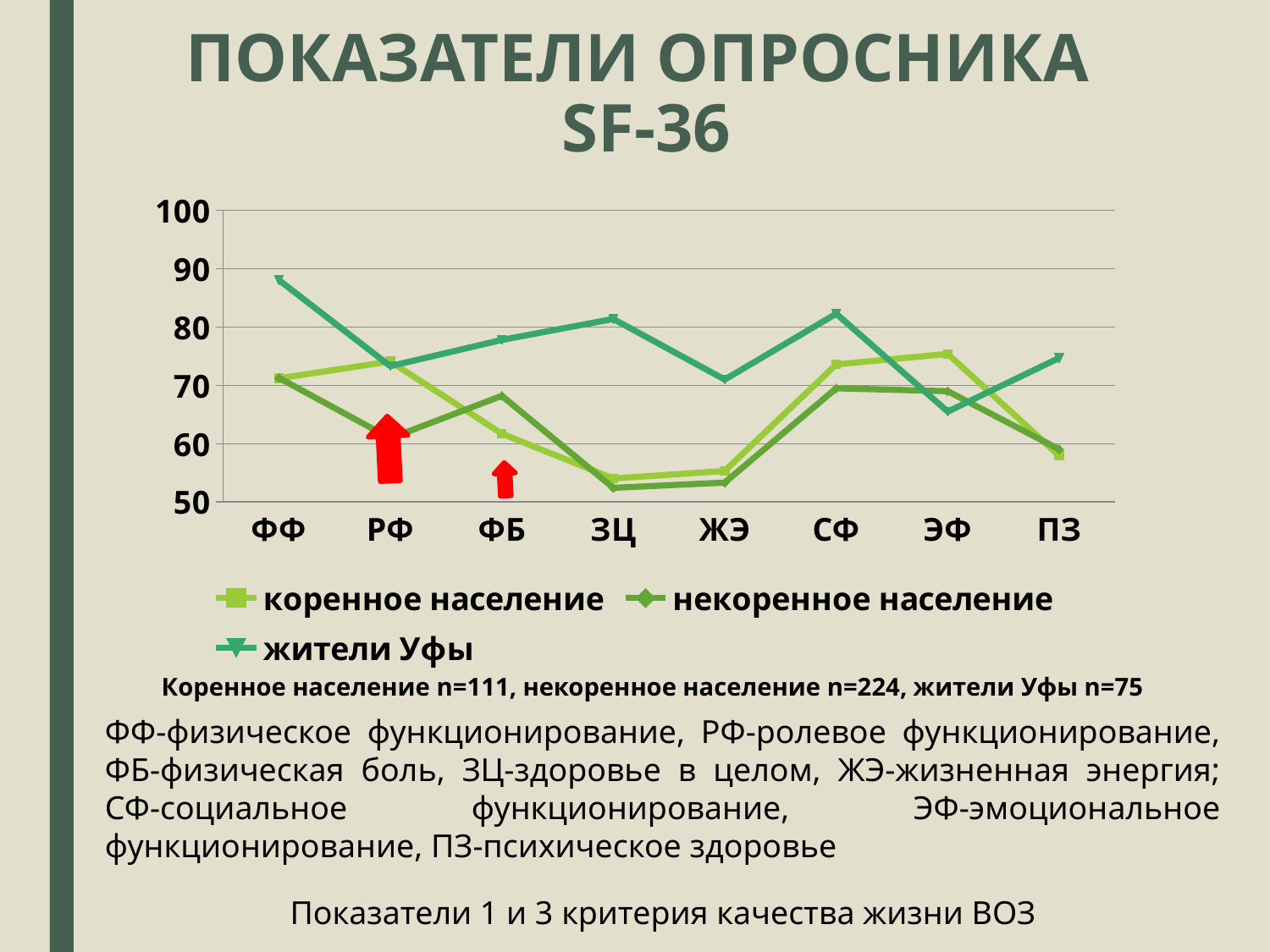
Is the value for некоренное население at ЖЭ greater or less than 60? less At РФ, which series has the larger value: коренное население or некоренное население? коренное население For the series жители Уфы, which category has the highest value? ФФ How many categories are shown on the x axis? 8 For the series жители Уфы, which category has the lowest value? ЭФ At ФБ, which series has the larger value: коренное население or некоренное население? некоренное население At ЭФ, which of the three series has the highest value? коренное население Is the value for коренное население at ЗЦ greater or less than 60? less How many series does the legend list? 3 Does the value for жители Уфы rise or fall from ФФ to РФ? fall What kind of chart is shown on the slide? line chart Is the value for жители Уфы at ФФ greater or less than 80? greater